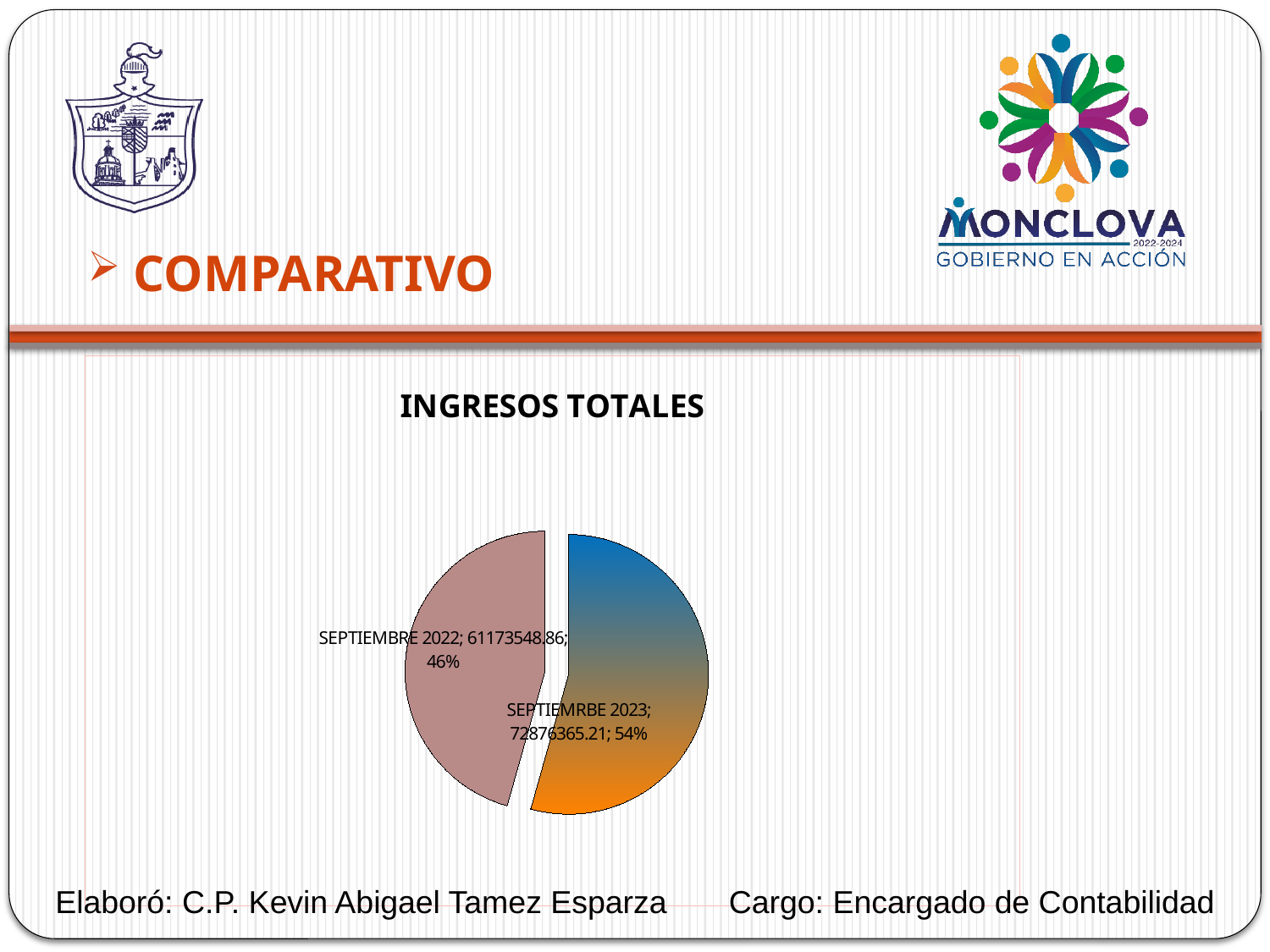
How many slices does the INGRESOS TOTALES pie chart have? 2 What is the combined total of the two slices in the pie chart? 134049914.07 Which slice of the pie chart is the largest? SEPTIEMRBE 2023 What is the value shown for SEPTIEMRBE 2023 in the pie chart? 72876365.21 Which slice of the pie chart is the smallest? SEPTIEMBRE 2022 What share of the pie does the SEPTIEMRBE 2023 slice represent? 54% Which is larger, the value for SEPTIEMBRE 2022 or the value for SEPTIEMRBE 2023? SEPTIEMRBE 2023 What kind of chart is shown under the title INGRESOS TOTALES? pie chart What is the difference between the SEPTIEMRBE 2023 value and the SEPTIEMBRE 2022 value? 11702816.35 What is the title of the chart on the slide? INGRESOS TOTALES What is the value shown for SEPTIEMBRE 2022 in the pie chart? 61173548.86 What share of the pie does the SEPTIEMBRE 2022 slice represent? 46%